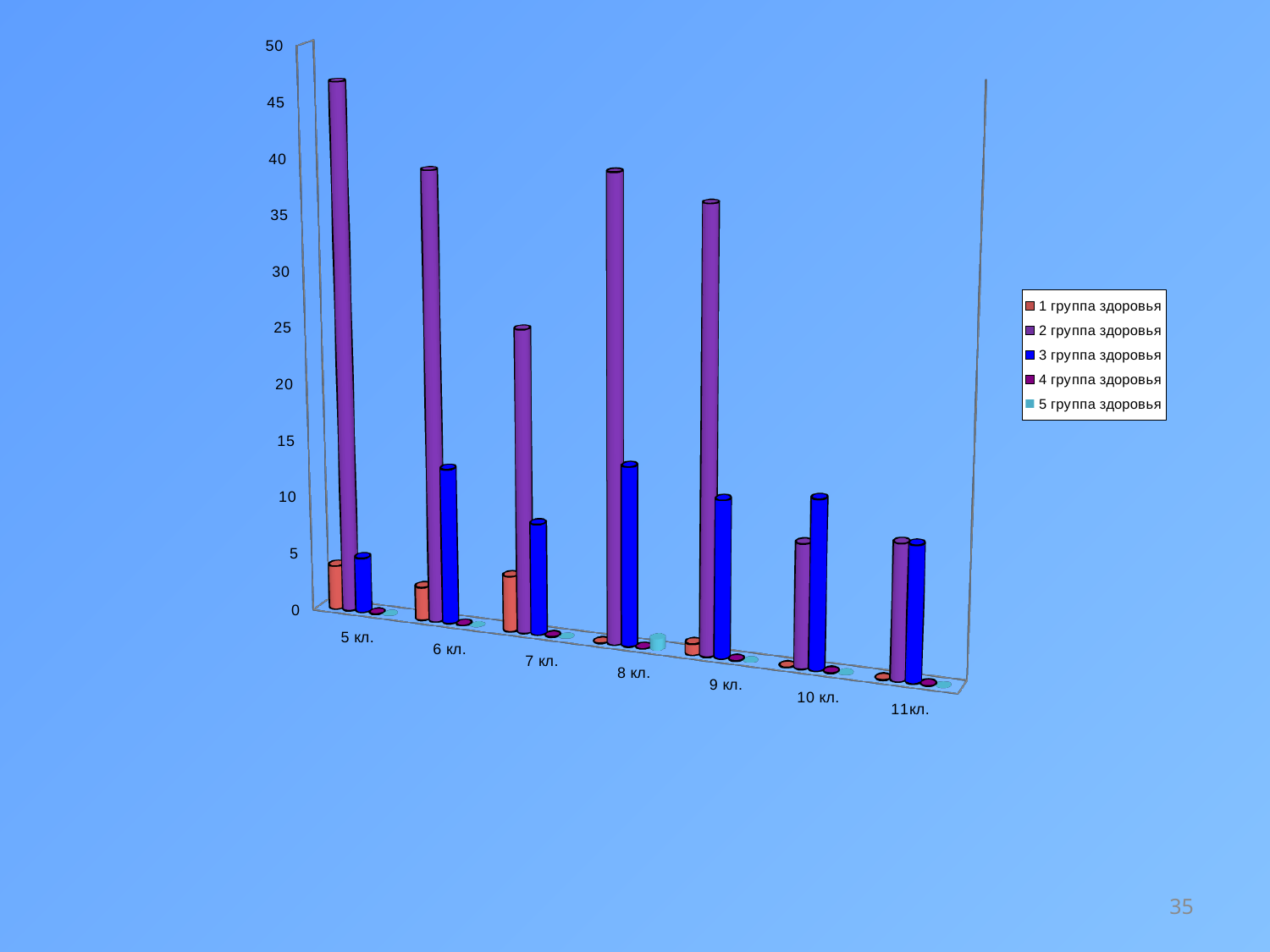
Is the value for 3 группа здоровья in 5 кл. greater or less than 10? less What colour are the bars for 3 группа здоровья? blue How many categories (classes) are shown on the x axis? 7 What kind of chart is shown on the slide? bar chart Which class has the highest value for 2 группа здоровья? 5 кл. Which is larger in 5 кл.: the value for 1 группа здоровья or 2 группа здоровья? 2 группа здоровья Is the value for 2 группа здоровья in 9 кл. greater or less than 30? greater Is the value for 1 группа здоровья in 5 кл. greater or less than 10? less Which is larger for 2 группа здоровья: 5 кл. or 7 кл.? 5 кл. How many series does the legend list? 5